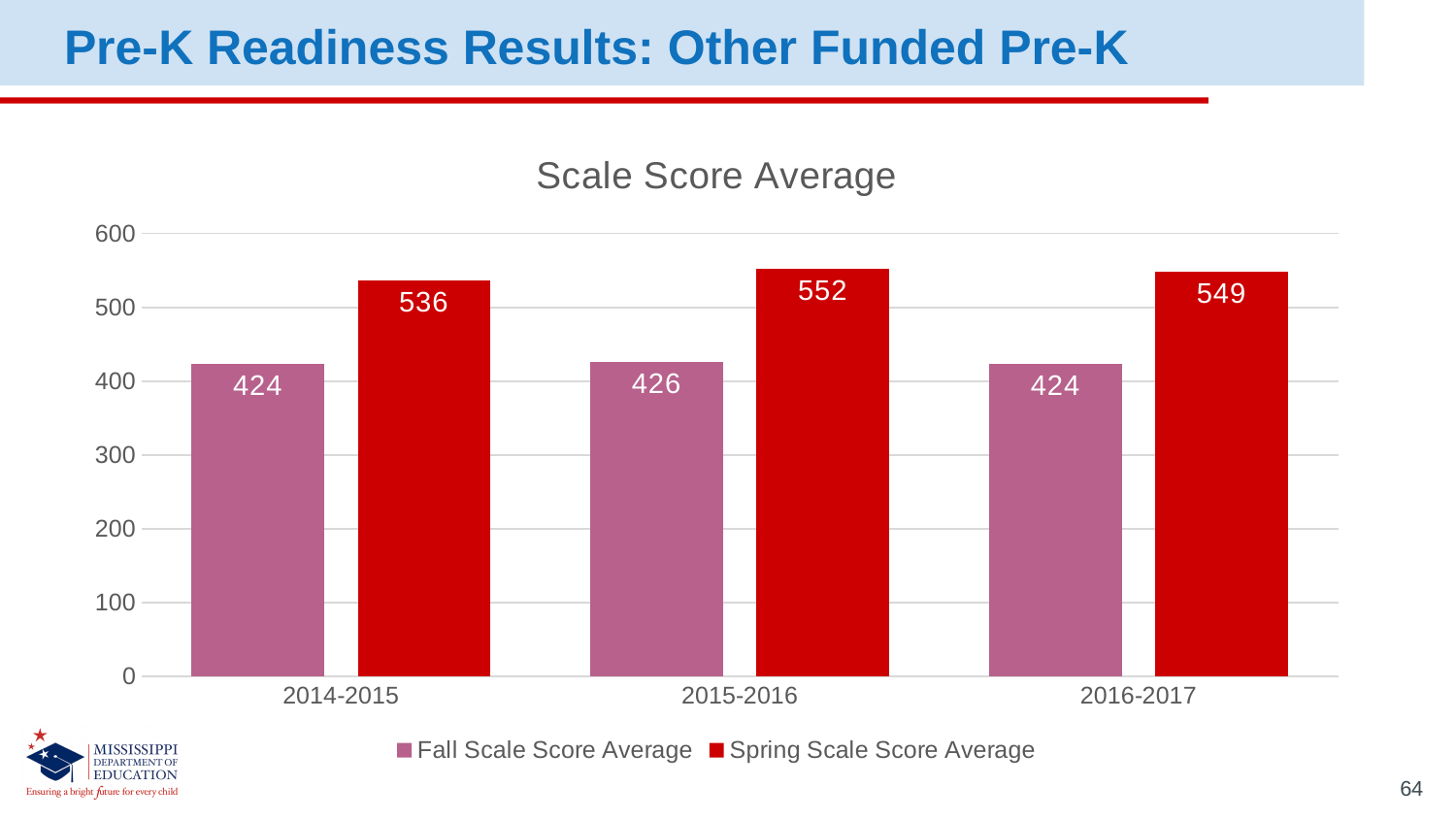
What is the Spring Scale Score Average for 2015-2016? 552 What is the difference between the Spring Scale Score Averages for 2015-2016 and 2016-2017? 3 How many series does the legend list? 2 What is the Spring Scale Score Average for 2016-2017? 549 Which year has the highest Fall Scale Score Average? 2015-2016 Is the Fall Scale Score Average for 2015-2016 greater or less than 500? less Which is larger, the Spring Scale Score Average for 2014-2015 or for 2016-2017? 2016-2017 What is the Fall Scale Score Average for 2014-2015? 424 How many school years are shown on the x axis? 3 Which year has the highest Spring Scale Score Average? 2015-2016 What is the difference between the Spring and Fall Scale Score Averages in 2014-2015? 112 What type of chart is shown on the slide? bar chart